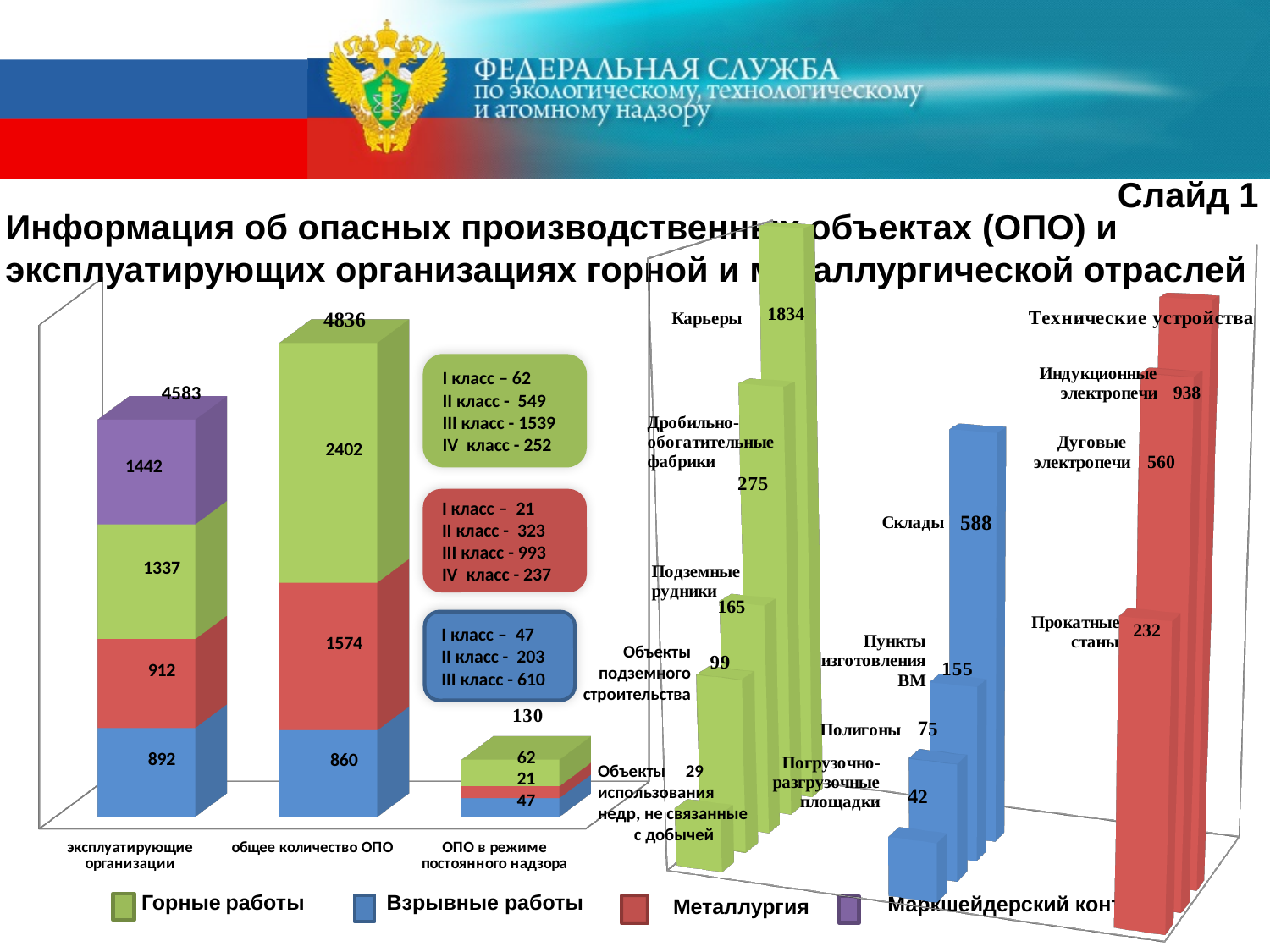
In the right chart, which is larger: 'Склады' or 'Дуговые электропечи'? Склады In the left stacked bar chart, what is the total for the bar labelled 'эксплуатирующие организации'? 4583 In the left stacked bar chart, what is the difference between the 'Горные работы' segments of 'общее количество ОПО' and 'эксплуатирующие организации'? 1065 In the left stacked bar chart, what is the value of the 'Металлургия' segment in the 'общее количество ОПО' bar? 1574 In the left stacked bar chart, which category has the lowest total? ОПО в режиме постоянного надзора In the right chart, what is the value for 'Индукционные электропечи'? 938 In the left stacked bar chart, what is the total for the bar labelled 'общее количество ОПО'? 4836 In the left stacked bar chart, how many series does the legend list? 4 In the left stacked bar chart, what is the value of the 'Маркшейдерский контроль' segment in the 'эксплуатирующие организации' bar? 1442 In the left stacked bar chart, what is the value of the 'Горные работы' segment in the 'ОПО в режиме постоянного надзора' bar? 62 What kind of chart is the left chart? Stacked bar chart In the right chart, what is the value for 'Карьеры'? 1834